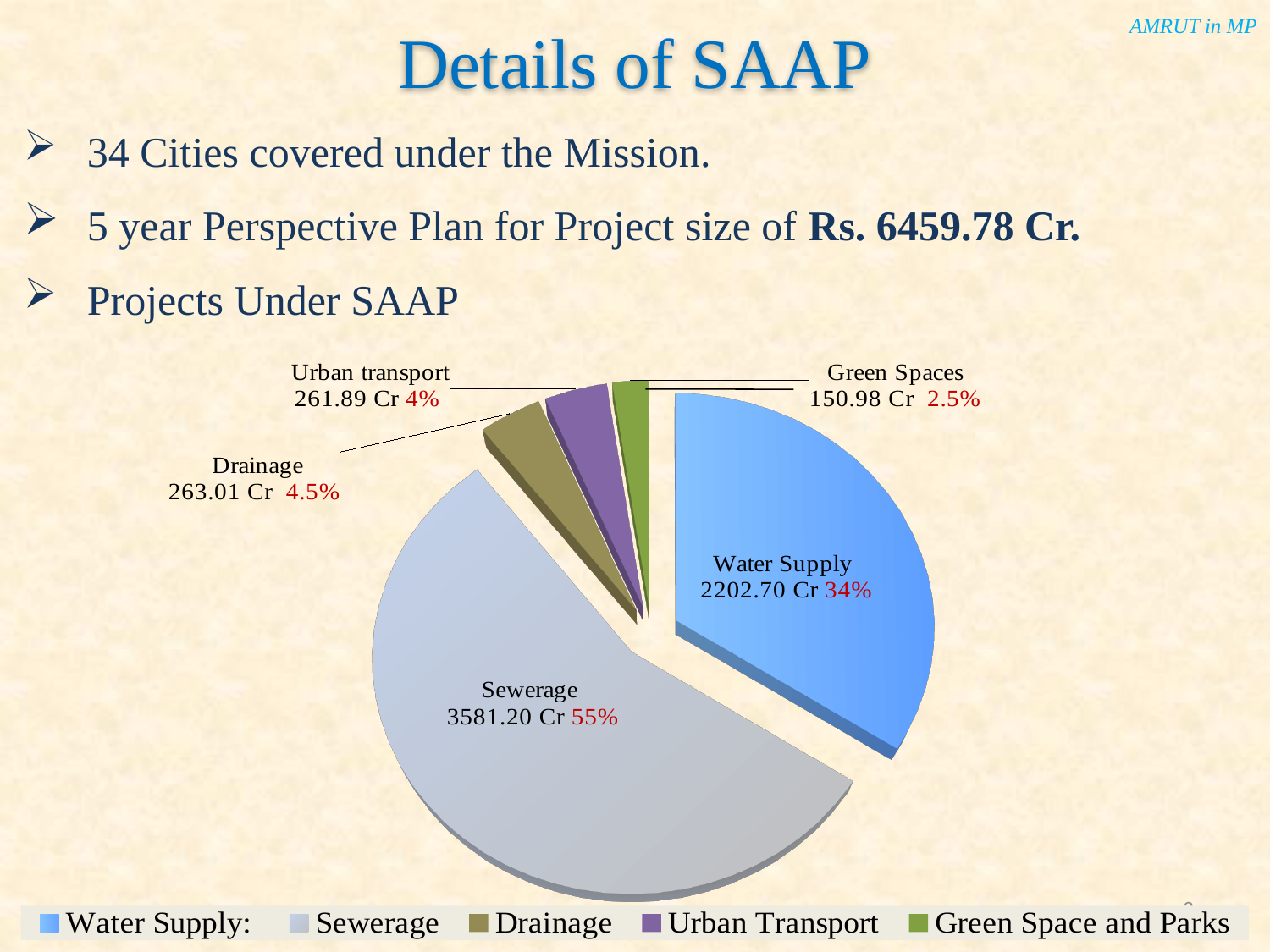
How many entries does the legend list? 5 What percentage share of the pie does Sewerage have? 55% What percentage share of the pie does Urban transport have? 4% What type of chart is shown on the slide? Pie chart What is the value shown for Green Spaces in the pie chart? 150.98 Cr Which category has the largest slice in the pie chart? Sewerage What is the value shown for Sewerage in the pie chart? 3581.20 Cr What is the value shown for Drainage in the pie chart? 263.01 Cr What is the value shown for Water Supply in the pie chart? 2202.70 Cr How many slices does the pie chart have? 5 Which category has the smallest slice in the pie chart? Green Spaces Which is larger in the pie chart, Water Supply or Drainage? Water Supply